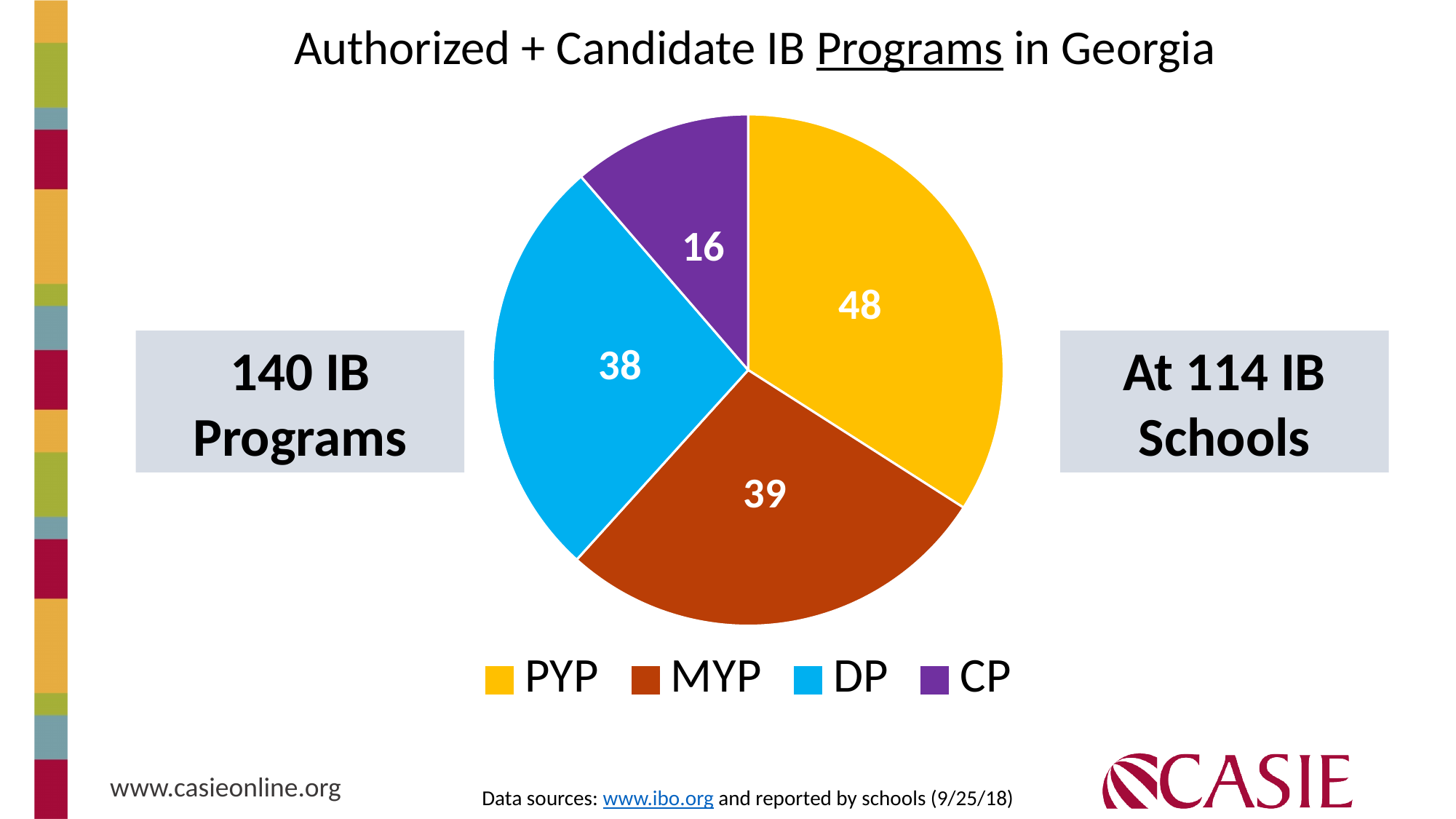
Which program has the largest slice of the pie chart? PYP Which is larger, the value for MYP or the value for DP? MYP What is the difference between the PYP value and the CP value? 32 What is the difference between the MYP value and the DP value? 1 What is the value for DP in the pie chart? 38 What is the value for MYP in the pie chart? 39 How many categories does the pie chart have? 4 What is the value for CP in the pie chart? 16 What is the title of the chart on the slide? Authorized + Candidate IB Programs in Georgia What is the value for PYP in the pie chart? 48 What type of chart is shown on the slide? pie chart Which program has the smallest slice of the pie chart? CP